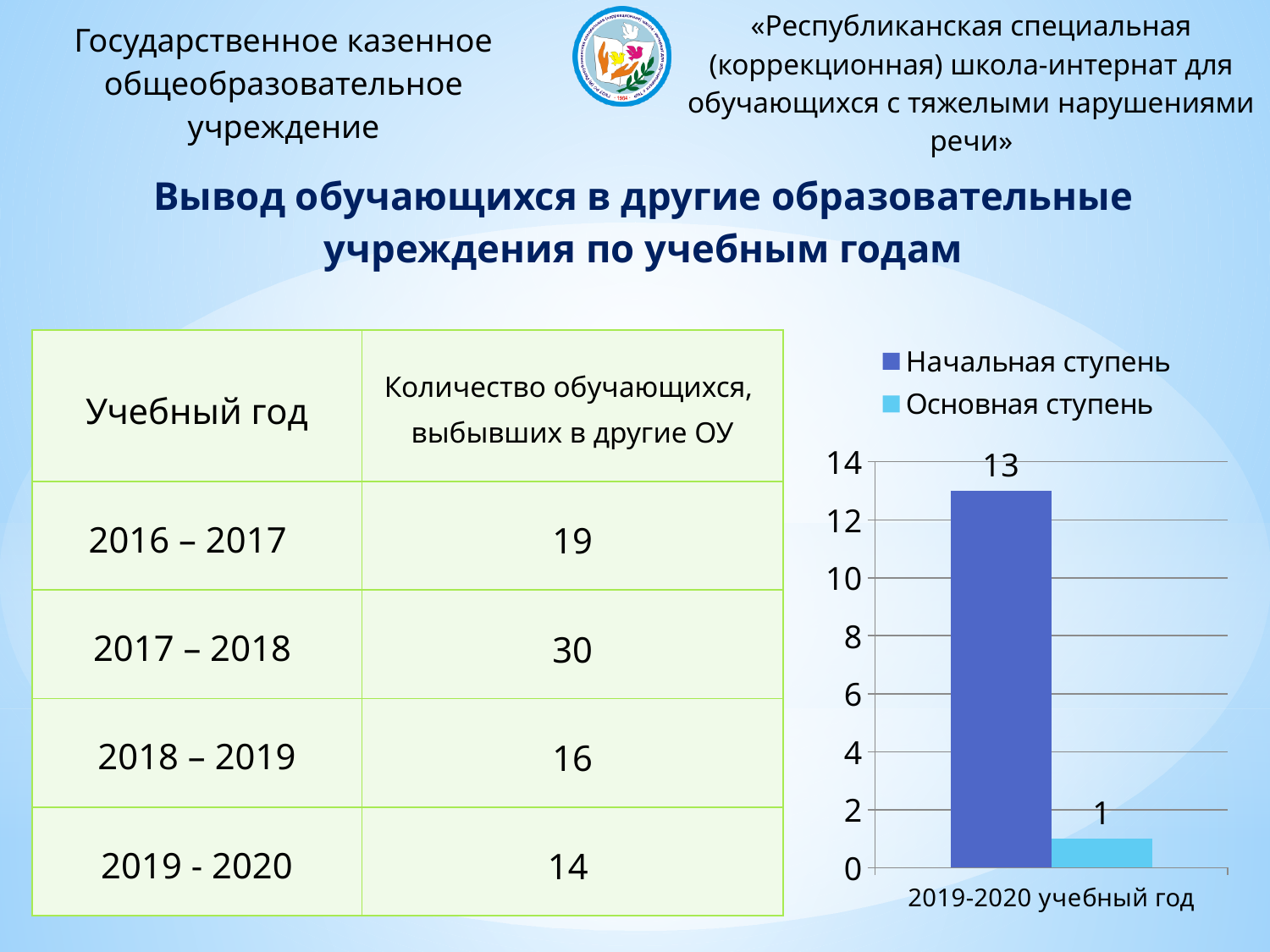
What is the highest value shown on the chart's y axis? 14 What is the category label on the x axis of the chart? 2019-2020 учебный год Which series has the higher value in the chart, Начальная ступень or Основная ступень? Начальная ступень What is the value for Основная ступень in the chart? 1 What kind of chart is shown on the slide? bar chart What is the value for Начальная ступень in the chart? 13 What is the difference between the values for Начальная ступень and Основная ступень in the chart? 12 Which series has the lowest value in the chart? Основная ступень Is the value for Начальная ступень greater or less than 10? greater How many categories are shown on the x axis of the chart? 1 What is the combined total of the two bars in the chart? 14 How many series does the chart legend list? 2